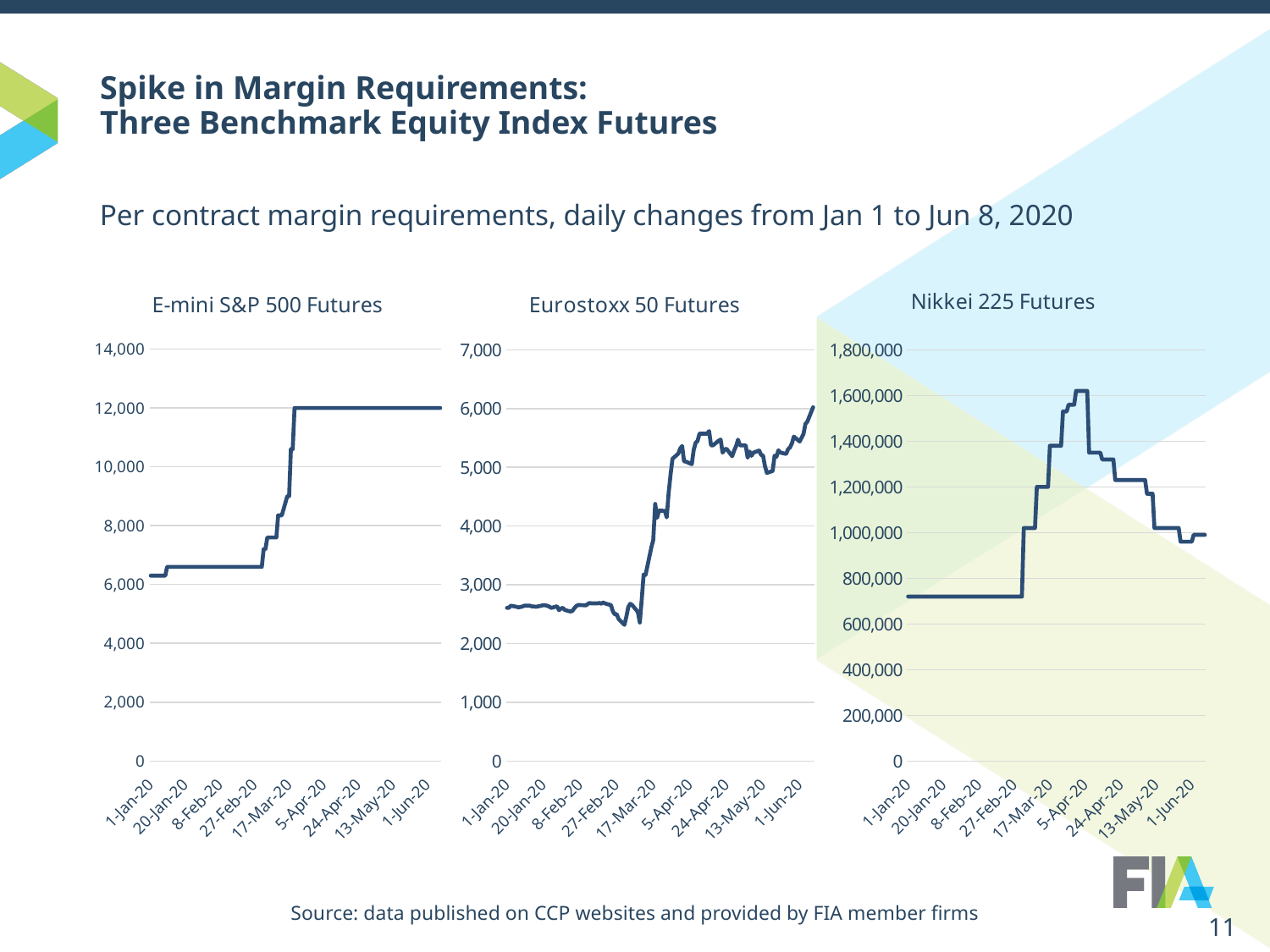
In the E-mini S&P 500 Futures chart, what value does the line plateau at from April 2020 onward? 12,000 In the E-mini S&P 500 Futures chart, is the value on 1-Jan-20 greater or less than 8,000? less In the Eurostoxx 50 Futures chart, is the value on 1-Jan-20 greater or less than 3,000? less In the Eurostoxx 50 Futures chart, is the value on 1-Jun-20 greater or less than 5,000? greater In the E-mini S&P 500 Futures chart, does the margin requirement rise or fall from January to June 2020? rise In the Nikkei 225 Futures chart, does the value rise or fall between early April and June 2020? fall What is the highest value shown on the y axis of the Nikkei 225 Futures chart? 1,800,000 How many charts are shown on the slide? 3 What kind of chart is the E-mini S&P 500 Futures chart? line chart What is the title of the rightmost chart on the slide? Nikkei 225 Futures